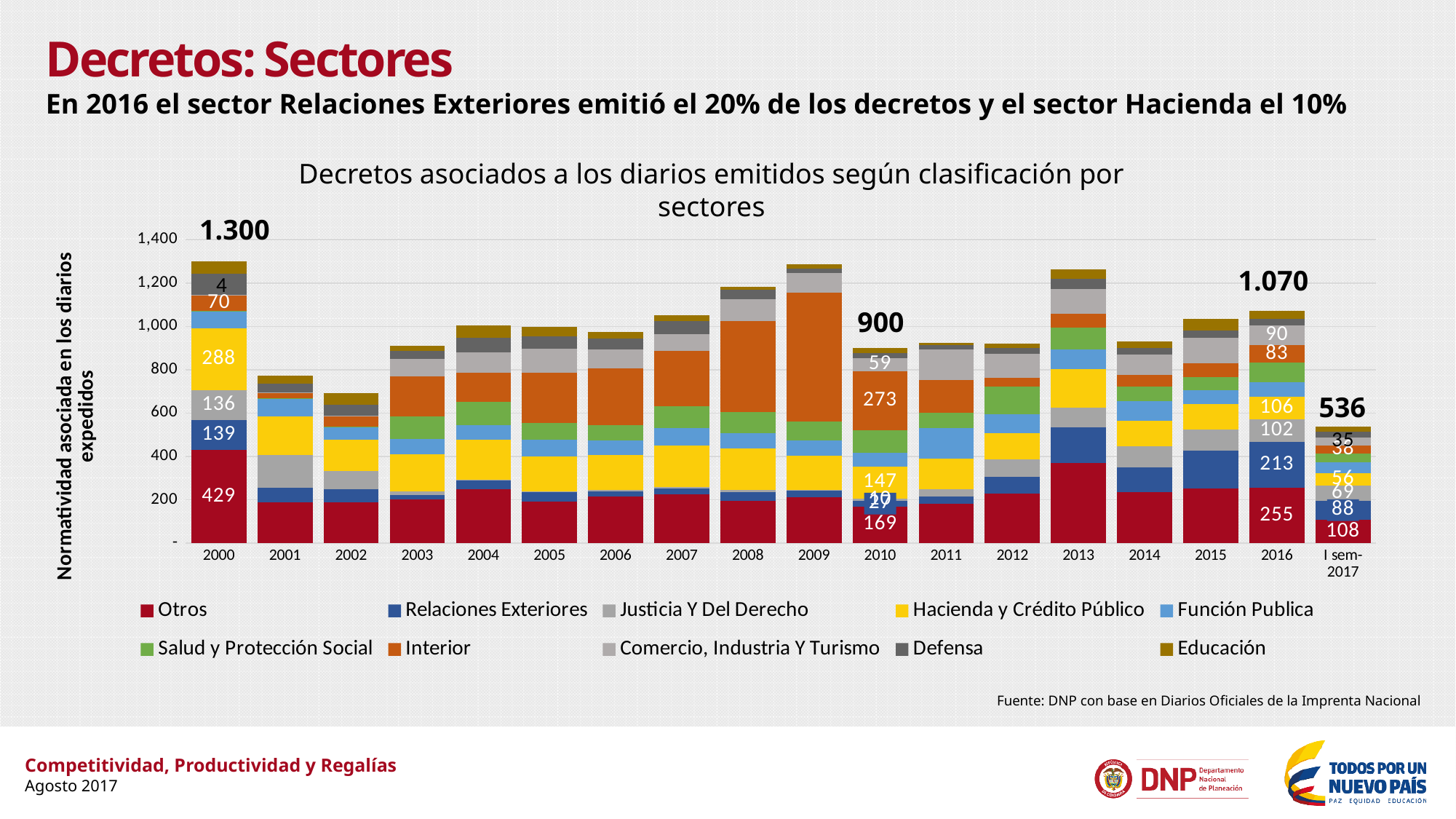
How many series does the legend list? 10 What is the total of the stacked bar for 2016? 1.070 Is the total for 2002 greater or less than 800? less What kind of chart is shown on the slide? Stacked bar chart What is the difference between the total for 2000 and the total for 2016? 230 What is the value for Relaciones Exteriores in 2016? 213 Which is larger, the value for Otros in 2000 or in 2016? 2000 What is the total of the stacked bar for I sem-2017? 536 How many periods (bars) are shown along the x axis? 18 What is the value for Hacienda y Crédito Público in 2000? 288 What is the value for Otros in 2000? 429 What is the value for Interior in 2010? 273